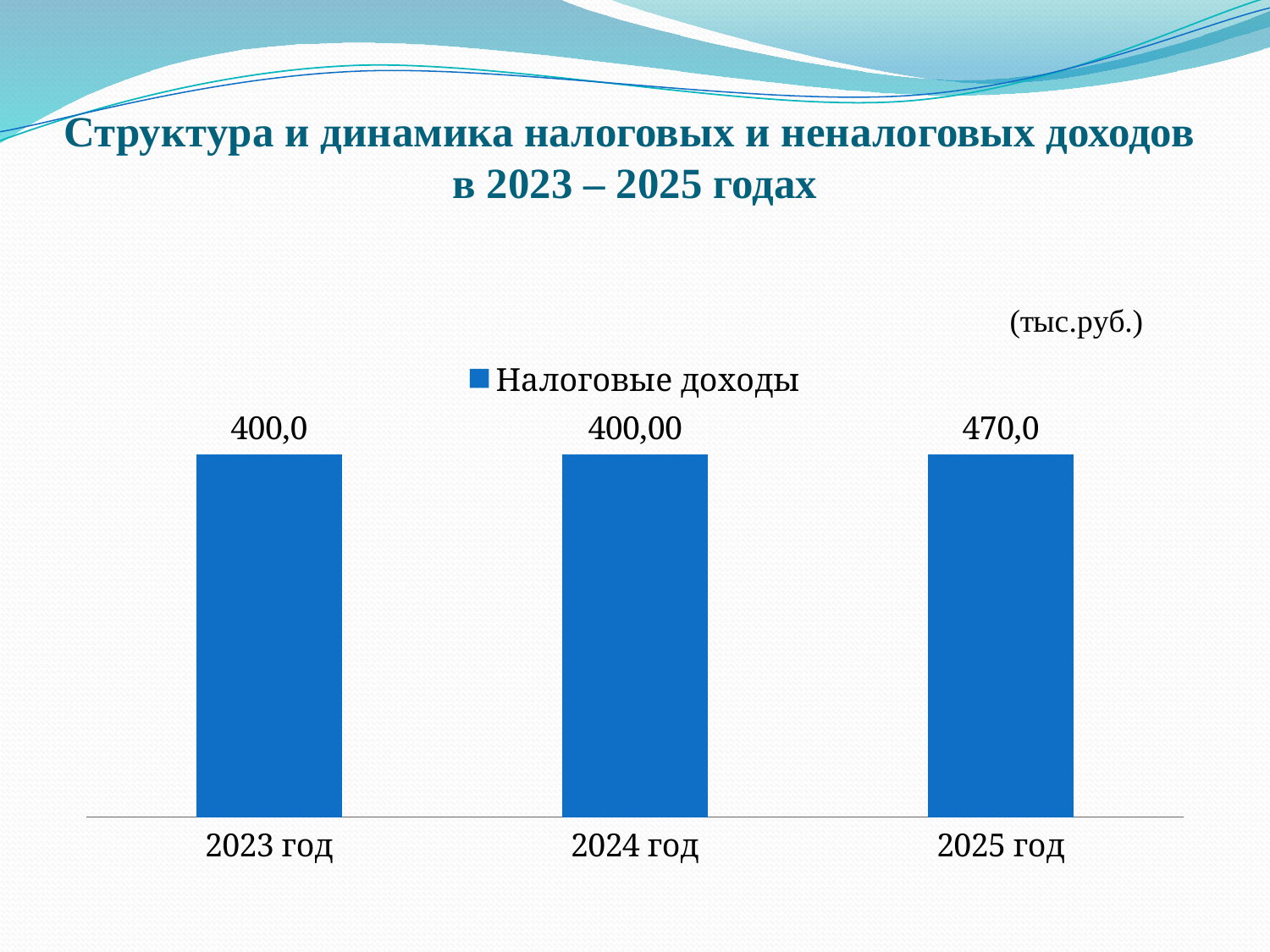
What series name is shown in the legend? Налоговые доходы What is the difference between the values for 2025 год and 2023 год? 70,0 What is the value for 2024 год? 400,00 Which is larger, the value for 2025 год or the value for 2024 год? 2025 год How many years are shown on the x axis? 3 Which year has the highest value? 2025 год What is the value for 2023 год? 400,0 What is the value for 2025 год? 470,0 What kind of chart is shown on the slide? bar chart What unit is indicated above the chart? (тыс.руб.) How many series does the legend list? 1